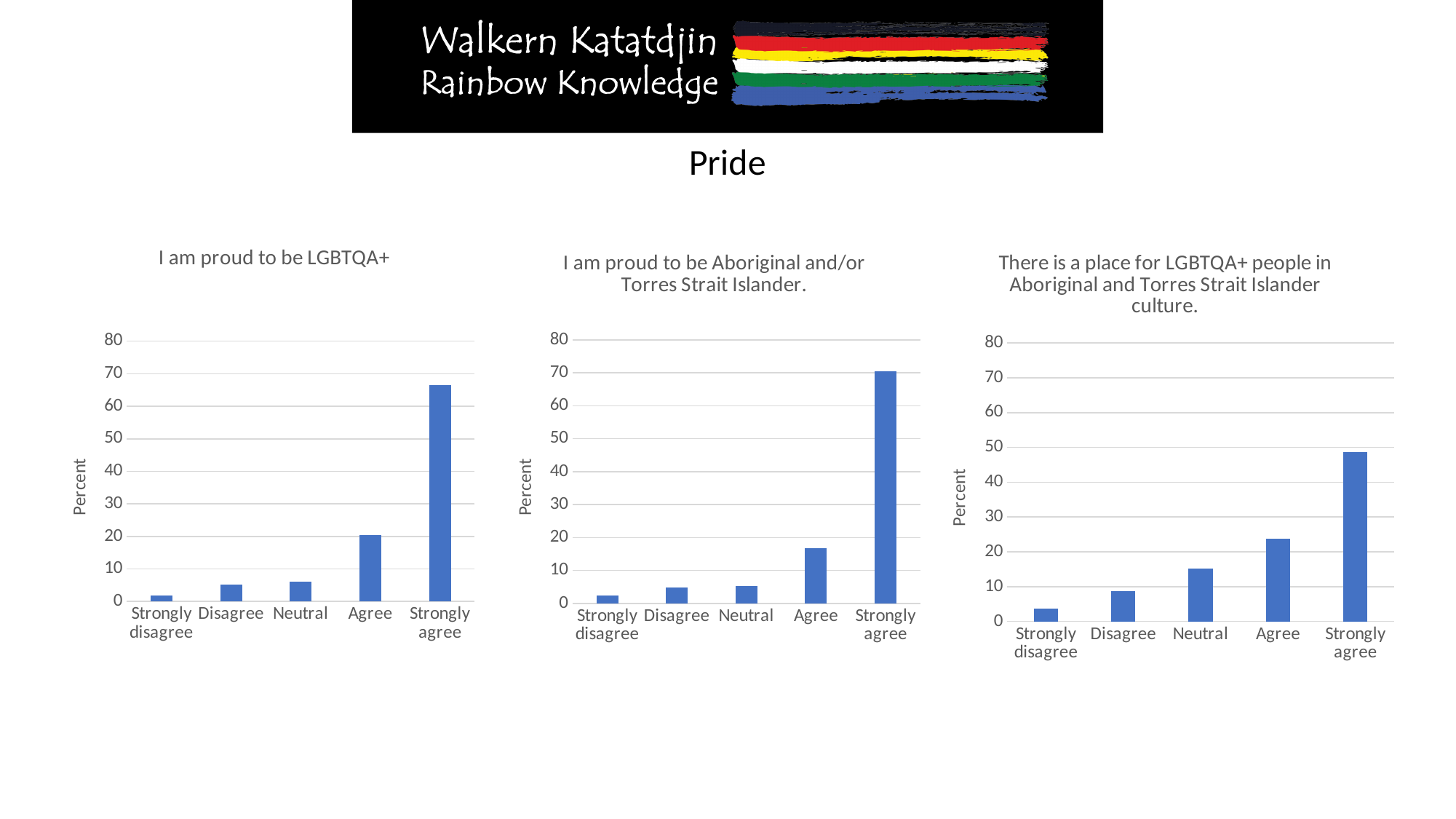
In the chart titled "I am proud to be Aboriginal and/or Torres Strait Islander.", how many categories are shown on the x axis? 5 In the chart titled "I am proud to be LGBTQA+", is the value for Agree greater or less than 30? less In the chart titled "There is a place for LGBTQA+ people in Aboriginal and Torres Strait Islander culture.", which category has the highest value? Strongly agree In the chart titled "There is a place for LGBTQA+ people in Aboriginal and Torres Strait Islander culture.", do the values rise or fall from Strongly disagree to Strongly agree? rise In the chart titled "I am proud to be Aboriginal and/or Torres Strait Islander.", which is larger, Agree or Neutral? Agree In the chart titled "I am proud to be Aboriginal and/or Torres Strait Islander.", is the value for Strongly agree greater or less than 60? greater In the chart titled "There is a place for LGBTQA+ people in Aboriginal and Torres Strait Islander culture.", is the value for Strongly agree greater or less than 40? greater In the chart titled "I am proud to be LGBTQA+", which category has the lowest value? Strongly disagree What kind of chart is the chart titled "I am proud to be LGBTQA+"? bar chart What is the label on the vertical axis of the chart titled "There is a place for LGBTQA+ people in Aboriginal and Torres Strait Islander culture."? Percent In the chart titled "I am proud to be LGBTQA+", which category has the highest value? Strongly agree